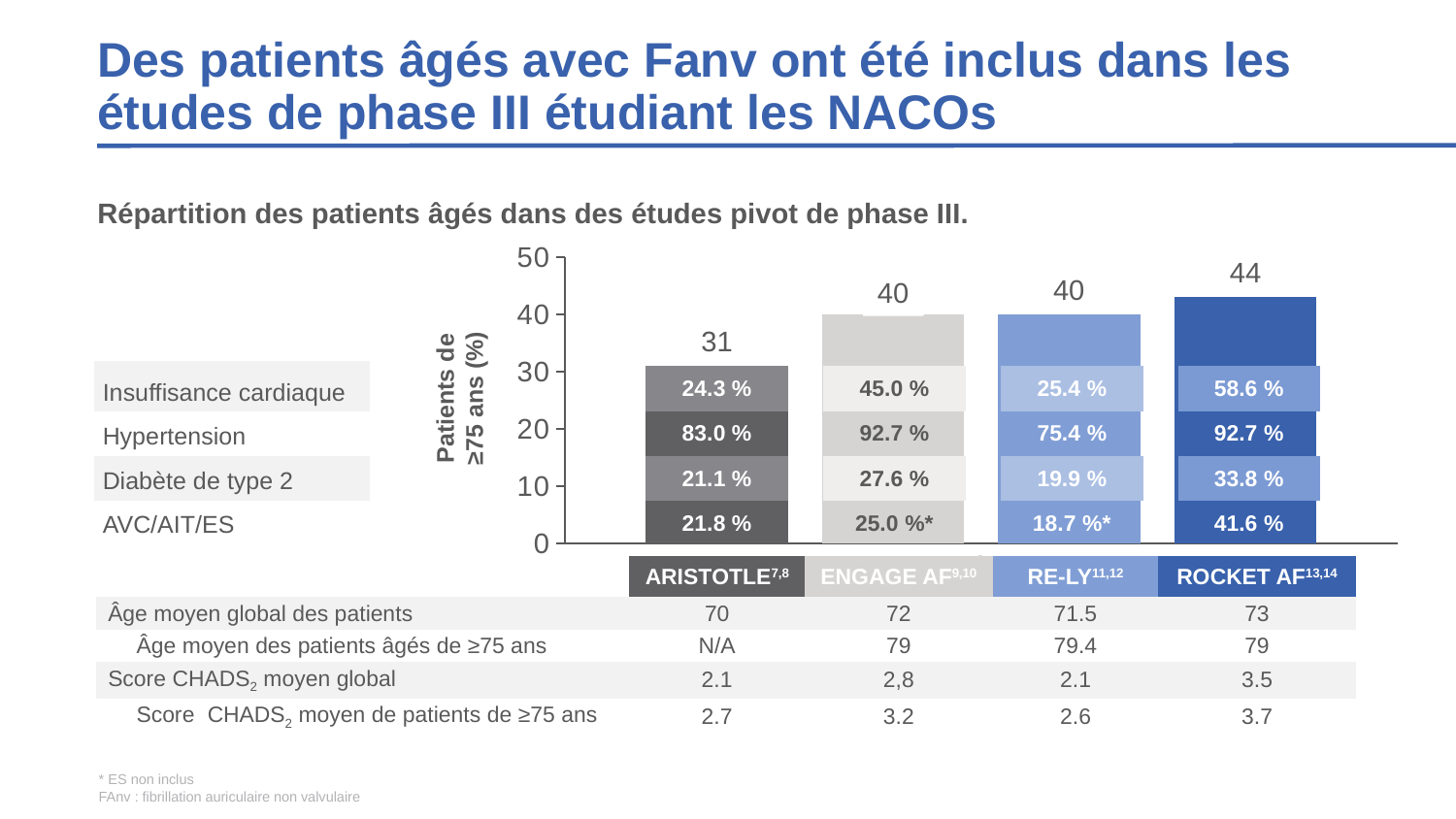
What is the percentage of patients aged ≥75 years in the ROCKET AF study? 44 Which is larger, the bar value for ENGAGE AF or for ARISTOTLE? ENGAGE AF Which study has the lowest percentage of patients aged ≥75 years? ARISTOTLE What kind of chart is used to show the share of patients aged ≥75 years? bar chart What is the difference between the ROCKET AF and ARISTOTLE bar values? 13 Which study has the highest percentage of patients aged ≥75 years? ROCKET AF How many studies are shown as bars in the chart? 4 What is the label of the vertical axis of the chart? Patients de ≥75 ans (%) Is the value for ARISTOTLE greater or less than 40? less What value is shown for the RE-LY bar? 40 What percentage is shown for Hypertension in the ROCKET AF bar? 92.7 % What is the percentage of patients aged ≥75 years in the ARISTOTLE study? 31